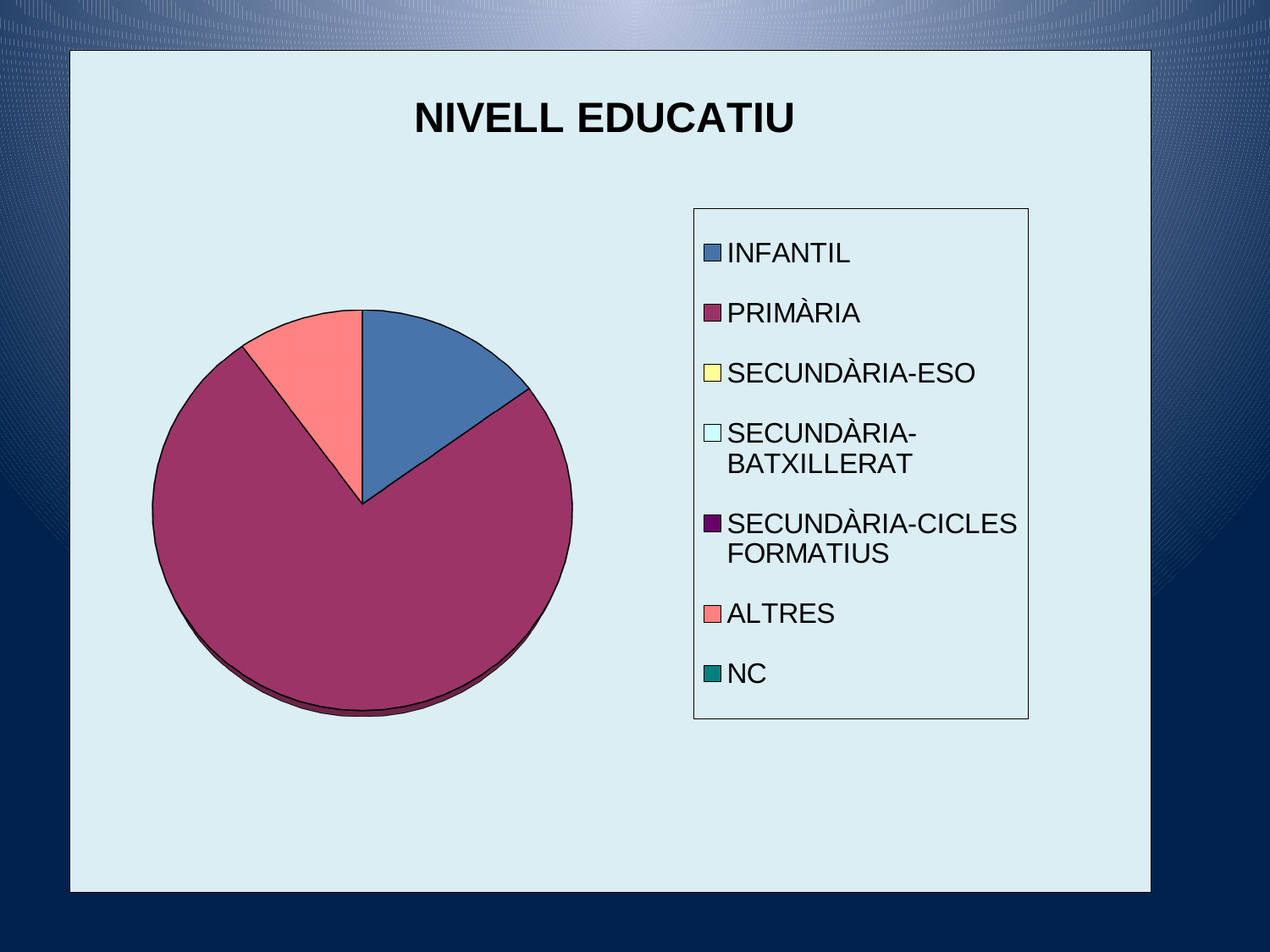
Which category has the largest slice of the pie? PRIMÀRIA Which slice is larger, PRIMÀRIA or INFANTIL? PRIMÀRIA Which of the visible slices is the smallest? ALTRES How many slices are visible in the pie chart? 3 Which slice is larger, PRIMÀRIA or ALTRES? PRIMÀRIA What is the title of the chart? NIVELL EDUCATIU How many categories does the legend list? 7 What colour is the PRIMÀRIA slice in the pie chart? maroon What kind of chart is shown on the slide? pie chart Which slice is larger, INFANTIL or ALTRES? INFANTIL